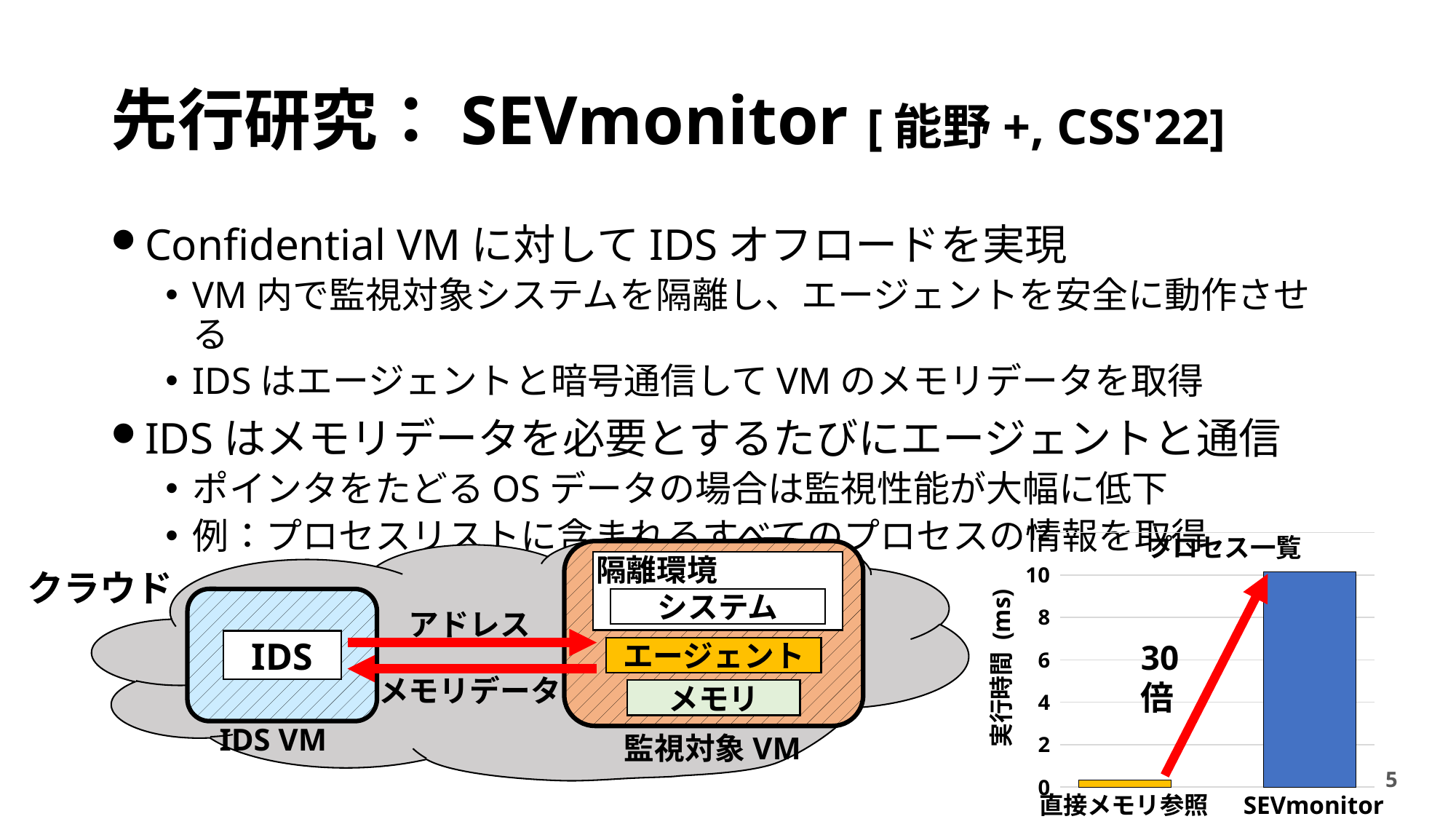
What ratio is annotated next to the red arrow in the bar chart? 30倍 Is the value for 直接メモリ参照 in the bar chart greater or less than 2? less Which category has the lowest execution time in the bar chart? 直接メモリ参照 Is the value for SEVmonitor in the bar chart greater or less than 4? greater What kind of chart is shown at the bottom right of the slide? bar chart What is the label of the y axis of the bar chart? 実行時間 (ms) Which category has the highest execution time in the bar chart? SEVmonitor Is the value for SEVmonitor in the bar chart greater or less than 8? greater How many categories are shown on the x axis of the bar chart? 2 In the bar chart, which is larger: the value for 直接メモリ参照 or the value for SEVmonitor? SEVmonitor